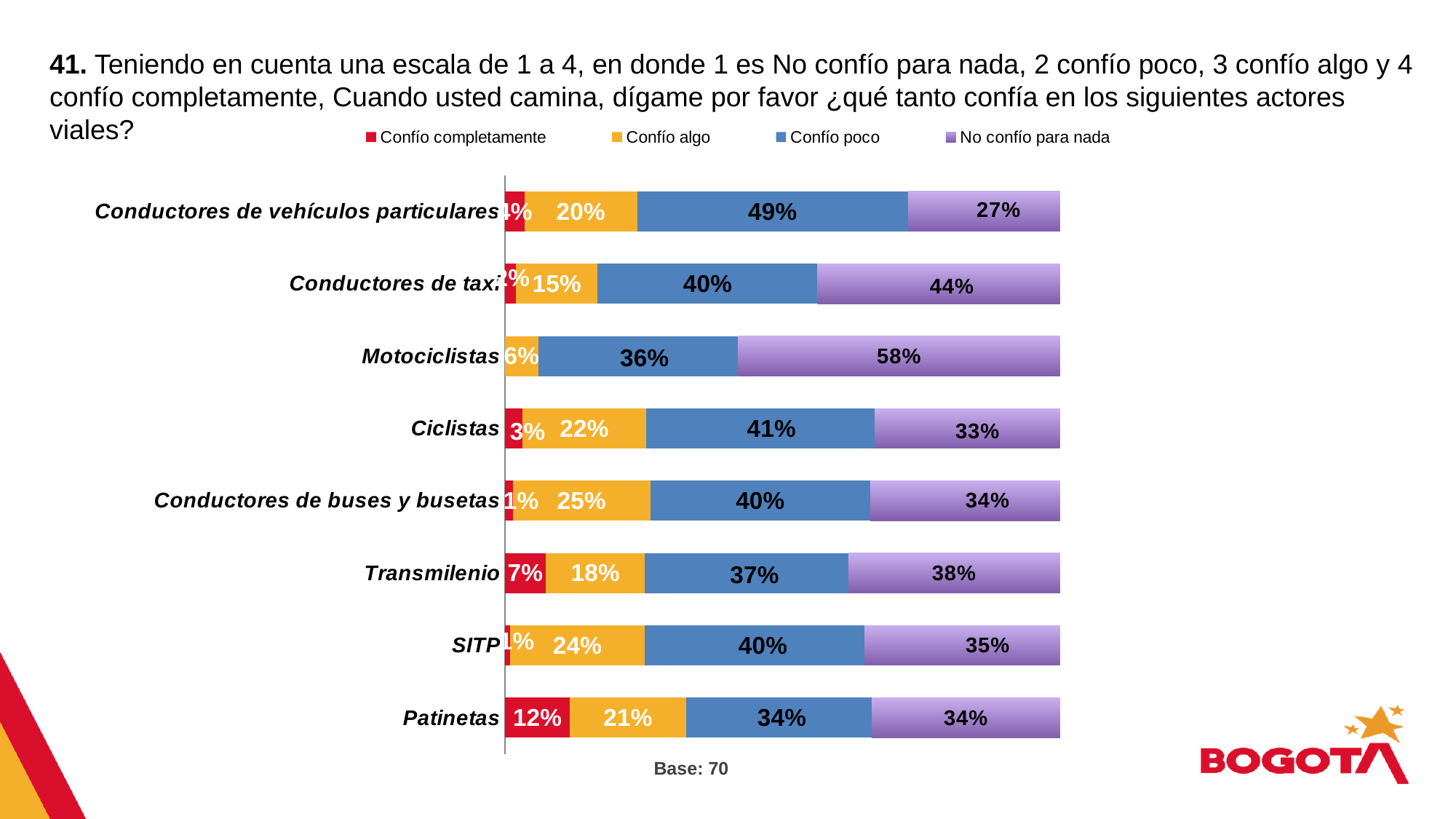
What is the difference between the 'No confío para nada' values for Motociclistas and Conductores de taxi? 14% Which category has the highest 'Confío completamente' value? Patinetas Which category has the highest 'No confío para nada' value? Motociclistas Which is larger: the 'Confío poco' value for Ciclistas or for Transmilenio? Ciclistas Which category has the lowest 'No confío para nada' value? Conductores de vehículos particulares What is the 'Confío poco' value for Conductores de vehículos particulares? 49% What is the 'Confío algo' value for Conductores de buses y busetas? 25% What percentage of respondents said 'No confío para nada' for Motociclistas? 58% How many series does the legend list? 4 How many categories (road actors) are shown in the chart? 8 What type of chart is shown on the slide? Stacked bar chart What is the 'Confío completamente' value for Patinetas? 12%